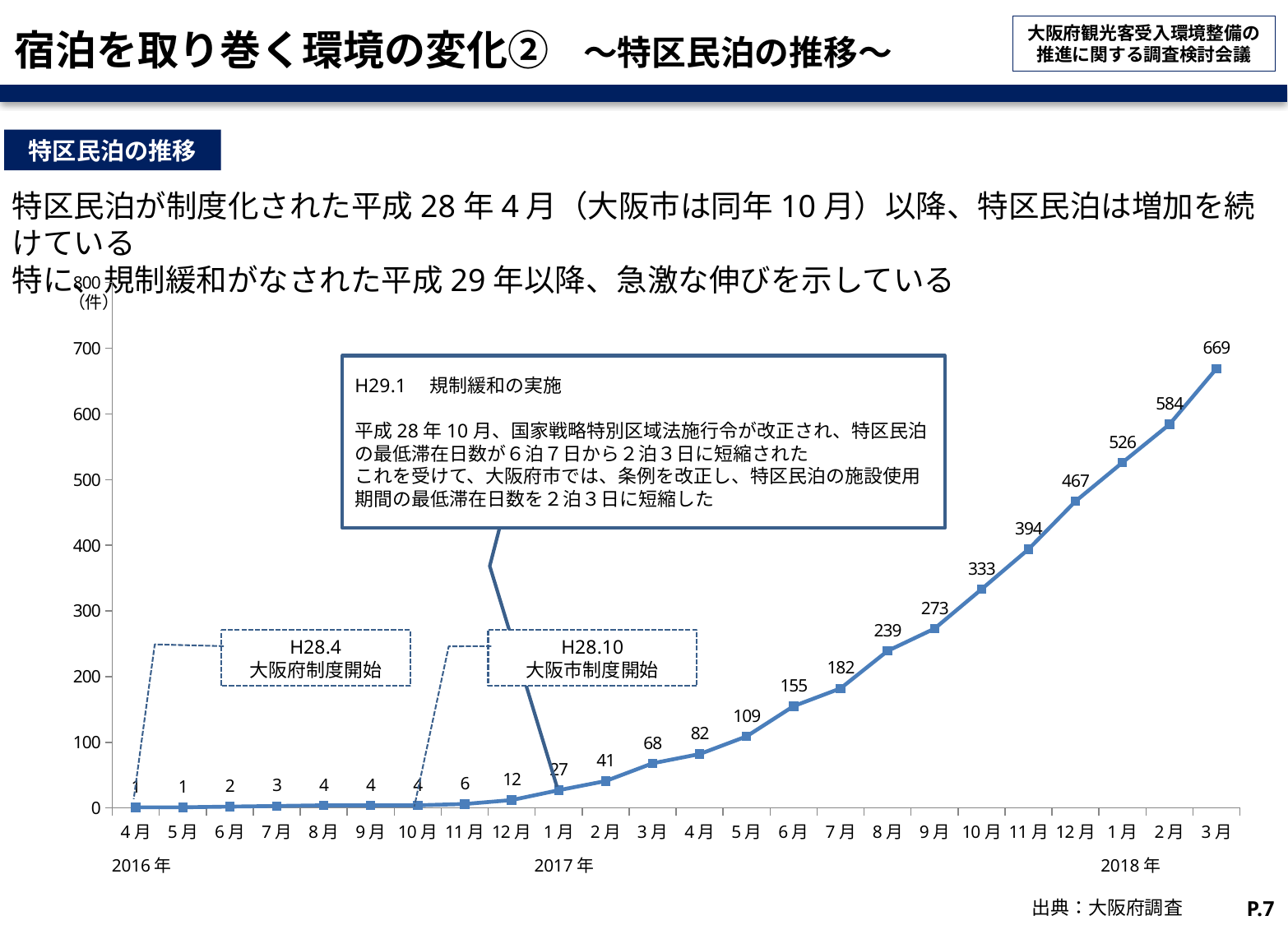
What is the difference between the values for 6月 2017年 and 5月 2017年? 46 What is the value for 3月 2018年 (March 2018)? 669 What is the value for 8月 2017年 (August 2017)? 239 How many data points are plotted on the chart? 24 Do the values rise or fall from 4月 2016年 to 3月 2018年? rise What is the value for 1月 2017年 (January 2017)? 27 What unit is shown at the top of the vertical axis? (件) What type of chart is shown on the slide? line chart Which is larger, the value for 9月 2017年 or the value for 10月 2017年? 10月 2017年 Which month has the highest value on the chart? 3月 2018年 (March 2018) What is the difference between the values for 2月 2018年 and 1月 2018年? 58 Is the value for 12月 2017年 greater or less than 400? greater